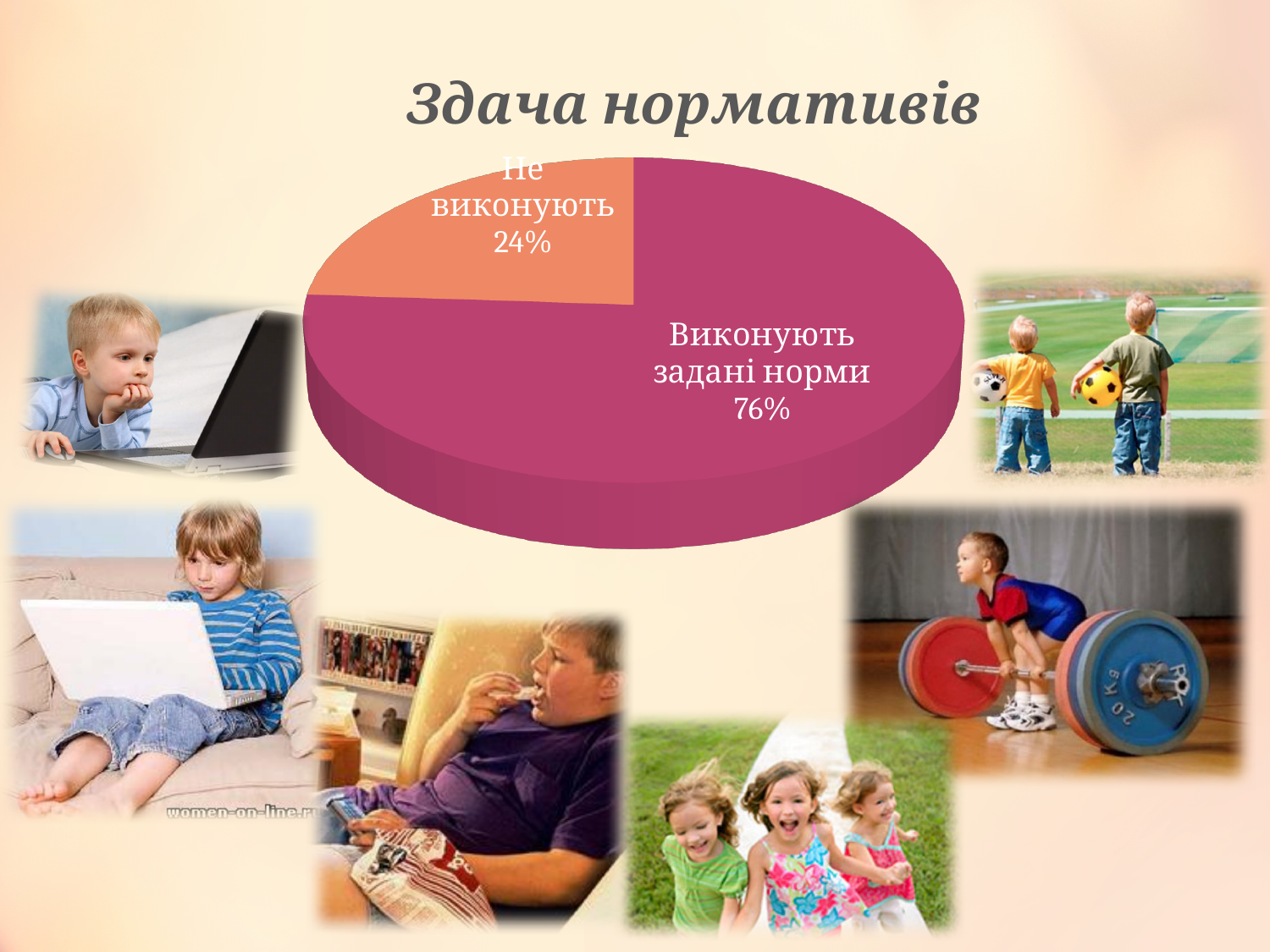
What share of the pie is labelled "Не виконують"? 24% What type of chart is shown on the slide? pie chart What colour is the "Не виконують" slice? orange Is the share for "Не виконують" greater or less than 50%? less Which slice of the pie is the smallest? Не виконують How many slices does the pie chart have? 2 Which is larger: the "Не виконують" slice or the "Виконують задані норми" slice? Виконують задані норми What is the title of the chart? Здача нормативів What is the difference in percentage points between the "Виконують задані норми" slice and the "Не виконують" slice? 52 What share of the pie is labelled "Виконують задані норми"? 76% Which slice of the pie is the largest? Виконують задані норми